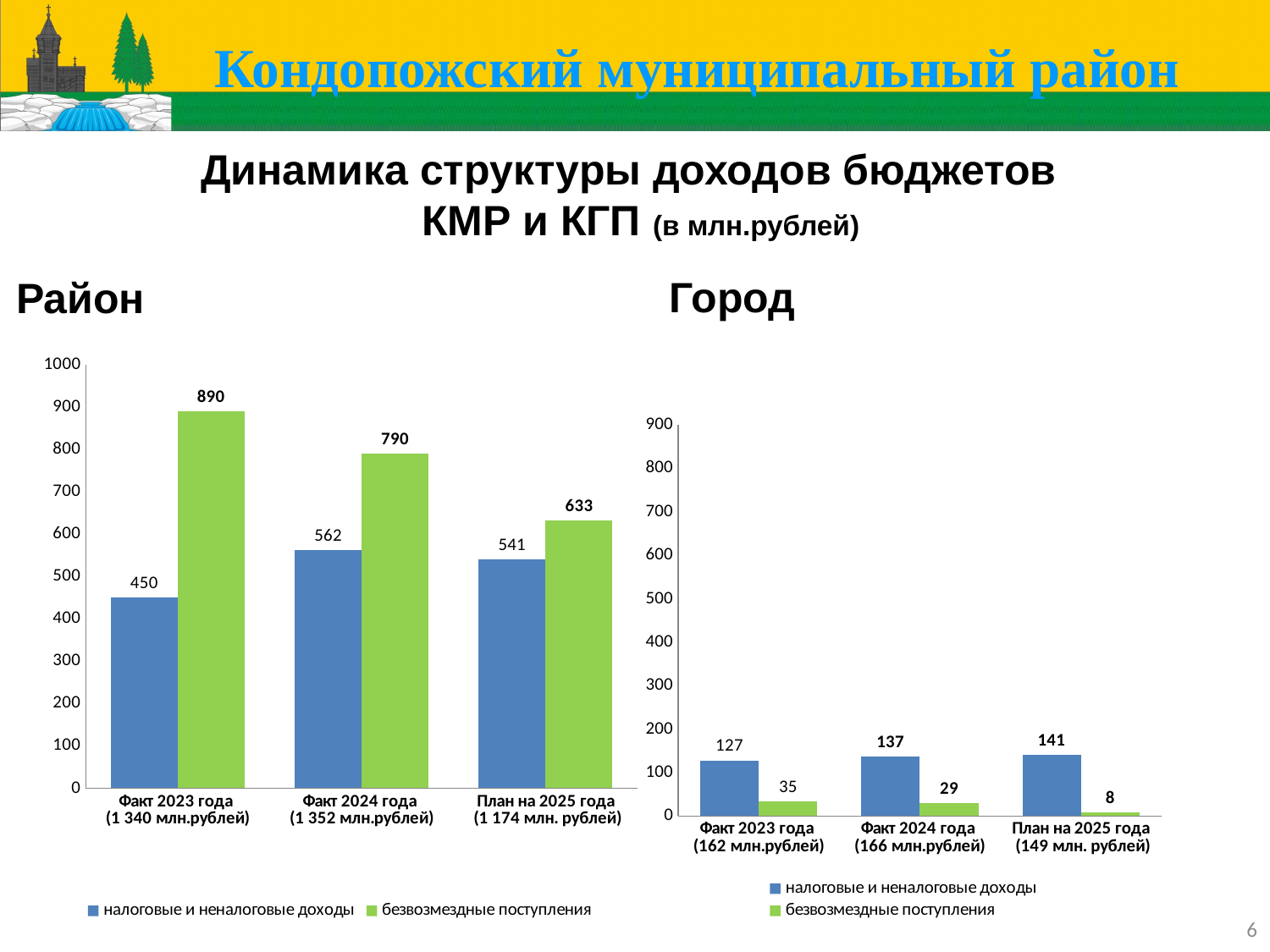
On the "Город" chart, which category has the lowest value for безвозмездные поступления? План на 2025 года On the "Район" chart, which is larger for План на 2025 года: налоговые и неналоговые доходы or безвозмездные поступления? безвозмездные поступления On the "Город" chart, what is the difference in налоговые и неналоговые доходы between План на 2025 года and Факт 2023 года? 14 On the "Район" chart, what is the value of безвозмездные поступления for Факт 2023 года? 890 On the "Город" chart, do the values for безвозмездные поступления rise or fall from Факт 2023 года to План на 2025 года? fall On the "Район" chart, what is the value of налоговые и неналоговые доходы for План на 2025 года? 541 How many series does the legend of the "Город" chart list? 2 What kind of chart is the "Район" chart? bar chart On the "Город" chart, what is the value of налоговые и неналоговые доходы for Факт 2024 года? 137 On the "Район" chart, which category has the highest value for безвозмездные поступления? Факт 2023 года On the "Район" chart, what is the difference between безвозмездные поступления and налоговые и неналоговые доходы for Факт 2024 года? 228 On the "Город" chart, what is the value of безвозмездные поступления for План на 2025 года? 8